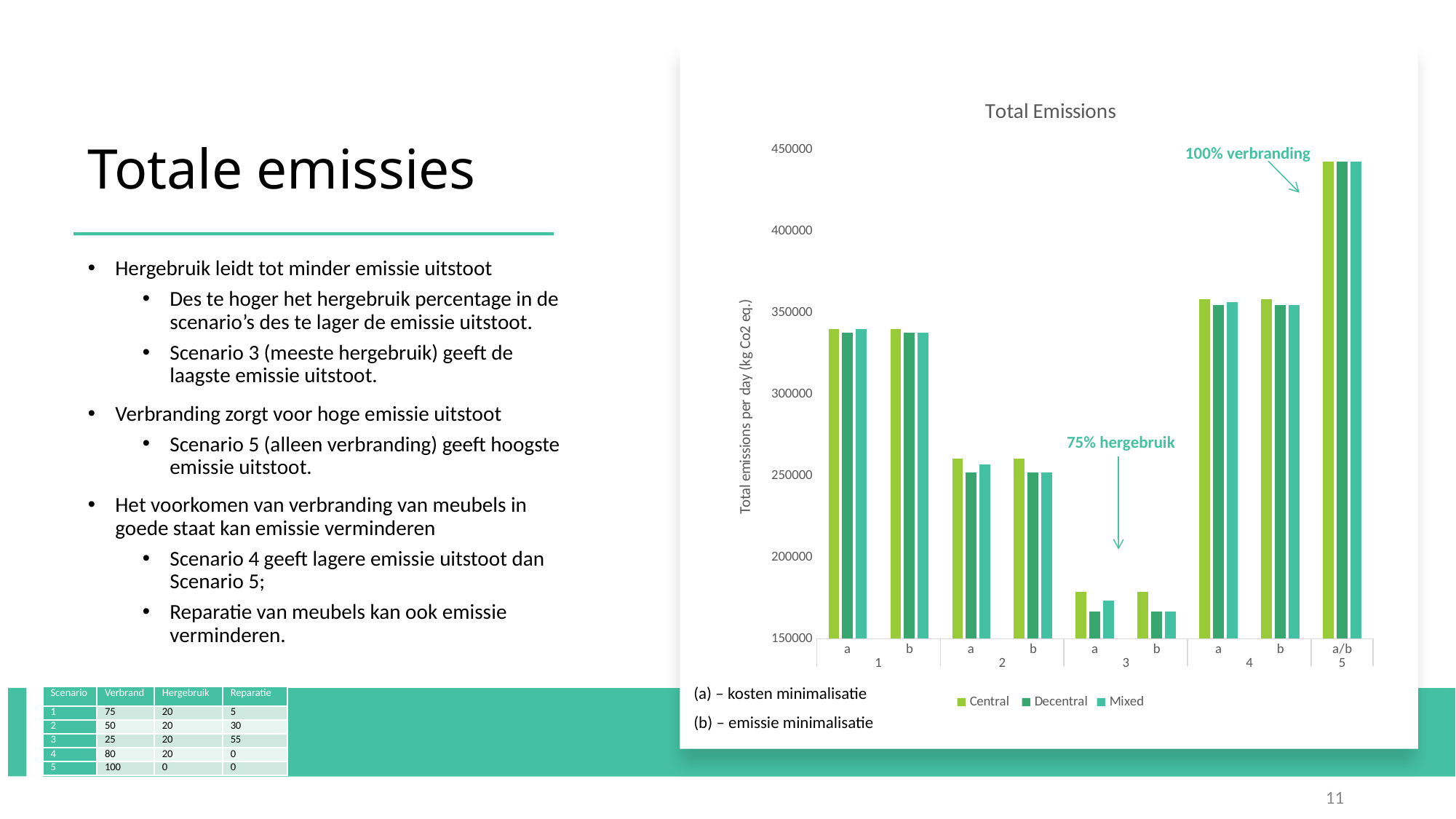
What is the title of the chart? Total Emissions Is the Central value for scenario 1 a greater or less than 350000? less Is the Central value for scenario 5 (a/b) greater or less than 400000? greater For scenario 3 a, which is larger: the Central value or the Decentral value? Central Which scenario has the lowest total emissions in the chart? Scenario 3 How many series does the chart legend list? 3 What kind of chart is shown on the slide? bar chart Is the Decentral value for scenario 3 b greater or less than 200000? less What are the series names listed in the chart legend? Central, Decentral, Mixed Which scenario has the highest total emissions in the chart? Scenario 5 (a/b)